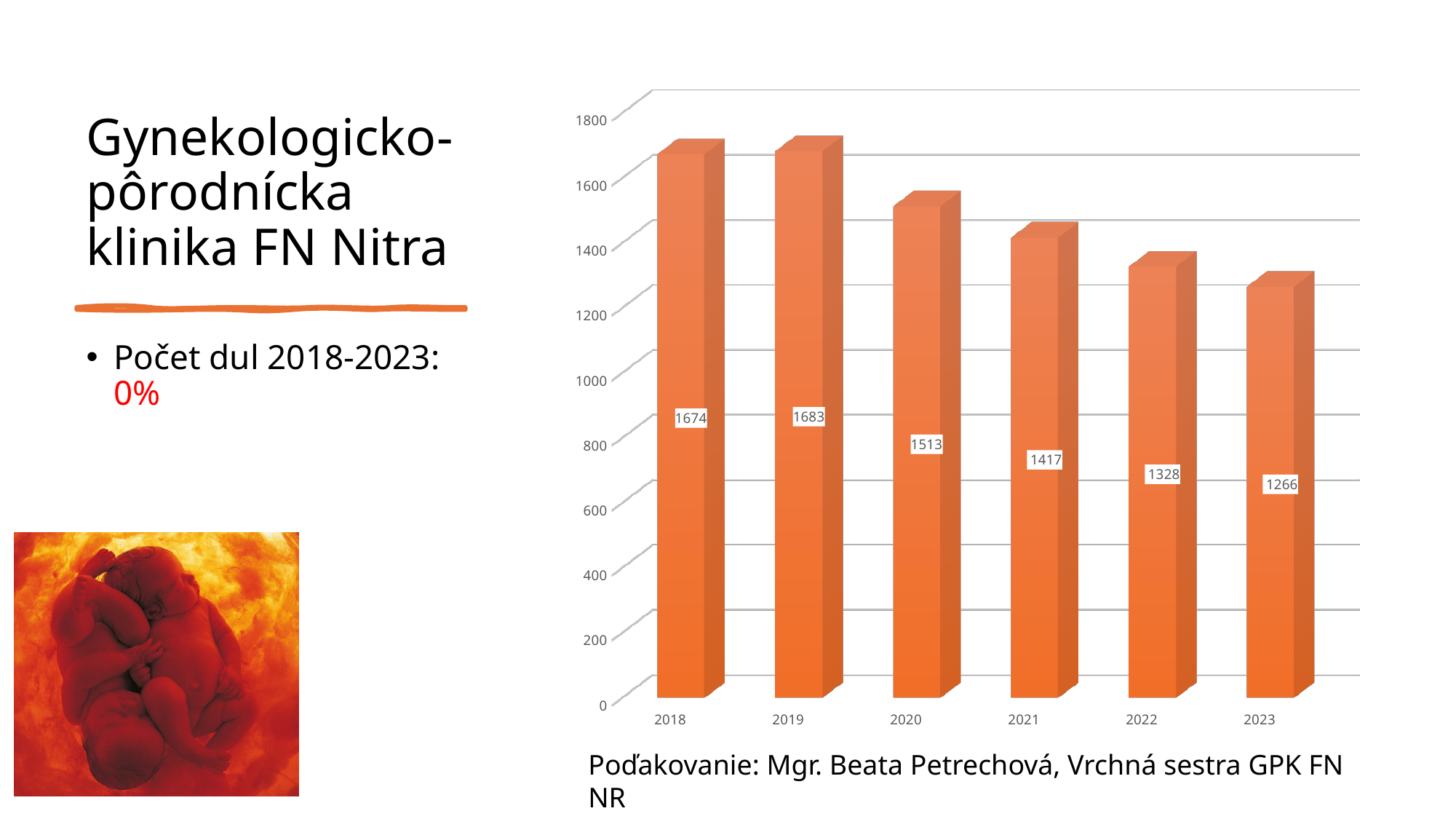
What is the value shown for 2021? 1417 What is the difference between the values for 2020 and 2021? 96 What kind of chart is shown on the slide? bar chart How many years are shown on the x axis? 6 Do the values generally rise or fall from 2019 to 2023? fall Is the value for 2022 greater or less than 1400? less What is the difference between the values for 2018 and 2023? 408 What is the value shown for 2023? 1266 What is the value shown for 2018? 1674 Which is larger, the value for 2019 or the value for 2020? 2019 Which year has the lowest value? 2023 Which year has the highest value? 2019